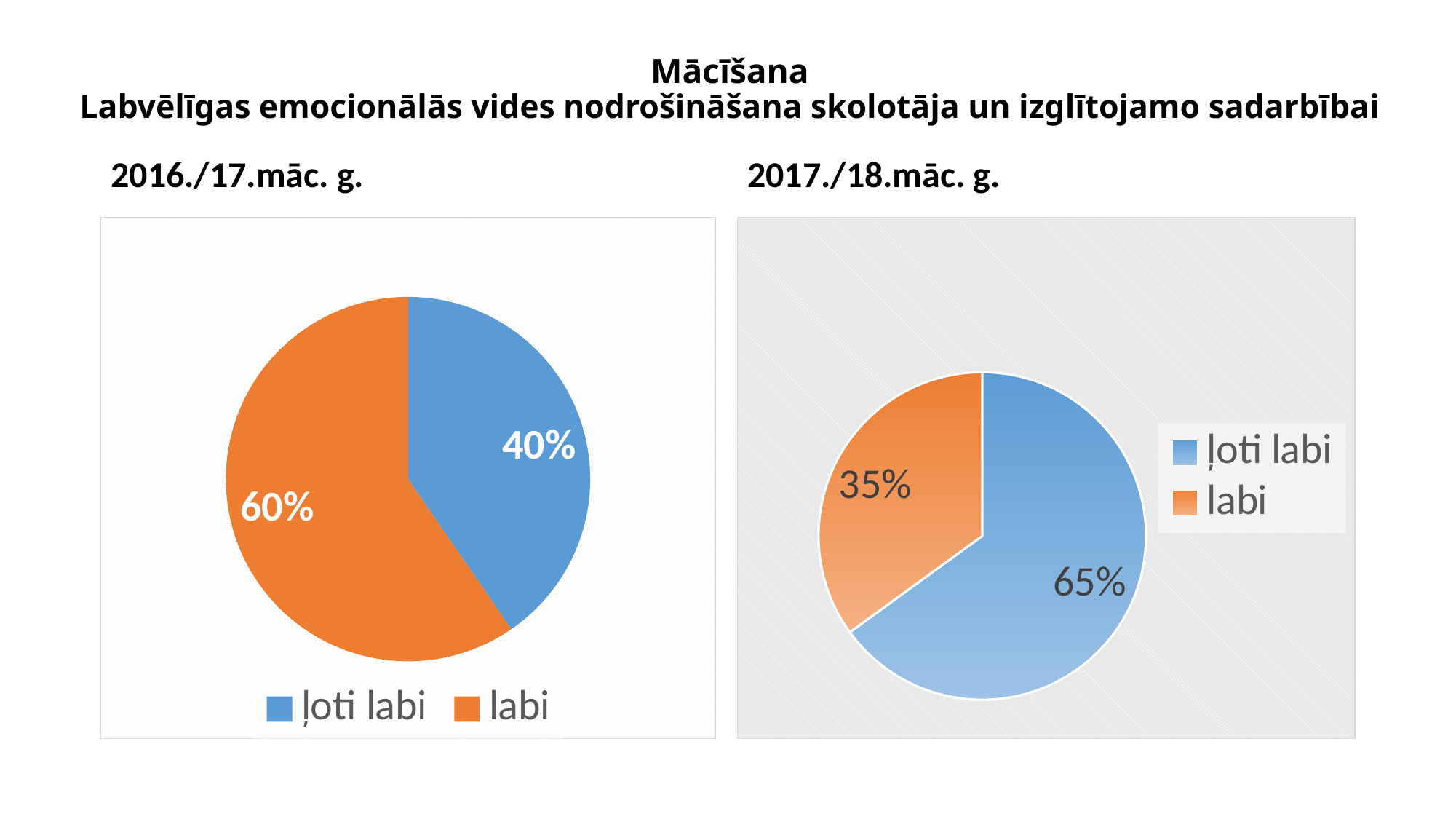
Is the value for ļoti labi larger in the 2016./17.māc. g. chart or the 2017./18.māc. g. chart? 2017./18.māc. g. In the 2017./18.māc. g. chart, which category has the smallest slice? labi How many slices does the 2017./18.māc. g. pie chart have? 2 In the 2016./17.māc. g. chart, what is the value for ļoti labi? 40% In the 2016./17.māc. g. chart, what is the difference between labi and ļoti labi? 20% In the 2017./18.māc. g. chart, what is the value for ļoti labi? 65% In the 2017./18.māc. g. chart, what is the difference between ļoti labi and labi? 30% In the 2016./17.māc. g. chart, which category has the largest slice? labi In the 2016./17.māc. g. chart, what is the value for labi? 60% In the 2017./18.māc. g. chart, what is the value for labi? 35% In the 2017./18.māc. g. chart, which colour represents ļoti labi? blue What kind of chart is the 2016./17.māc. g. chart? pie chart